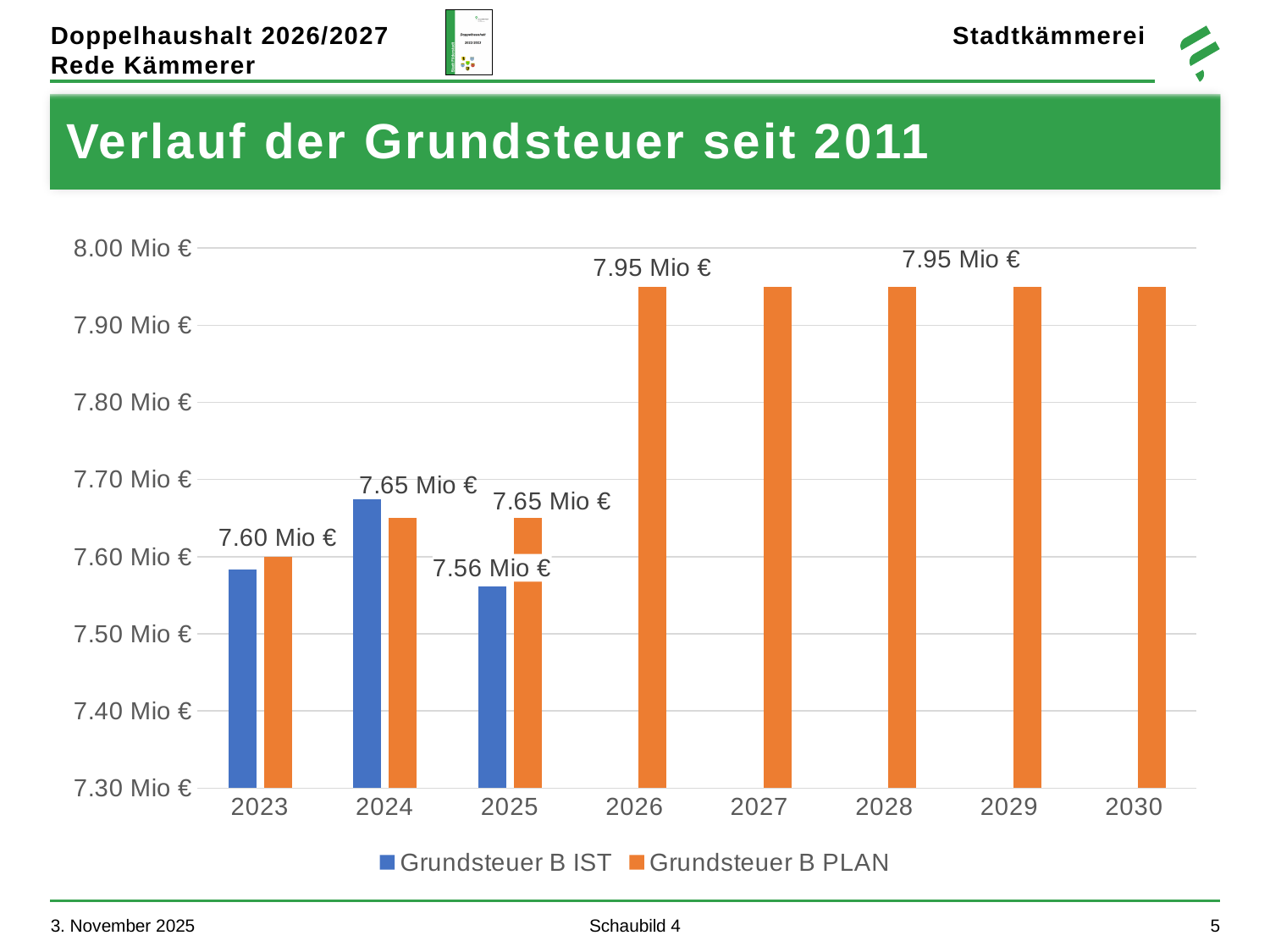
What is the title of the chart? Verlauf der Grundsteuer seit 2011 How many series does the legend list? 2 How many years are shown on the x axis? 8 What is the difference between Grundsteuer B PLAN and Grundsteuer B IST in 2025? 0.09 Mio € Is the Grundsteuer B IST value for 2024 greater or less than 7.60 Mio €? greater What is the Grundsteuer B PLAN value for 2025? 7.65 Mio € Which year has the highest Grundsteuer B IST value? 2024 What kind of chart is shown on the slide? bar chart What is the Grundsteuer B IST value for 2025? 7.56 Mio € What is the Grundsteuer B PLAN value for 2028? 7.95 Mio € In 2024, which is larger: Grundsteuer B IST or Grundsteuer B PLAN? Grundsteuer B IST What is the Grundsteuer B PLAN value for 2026? 7.95 Mio €